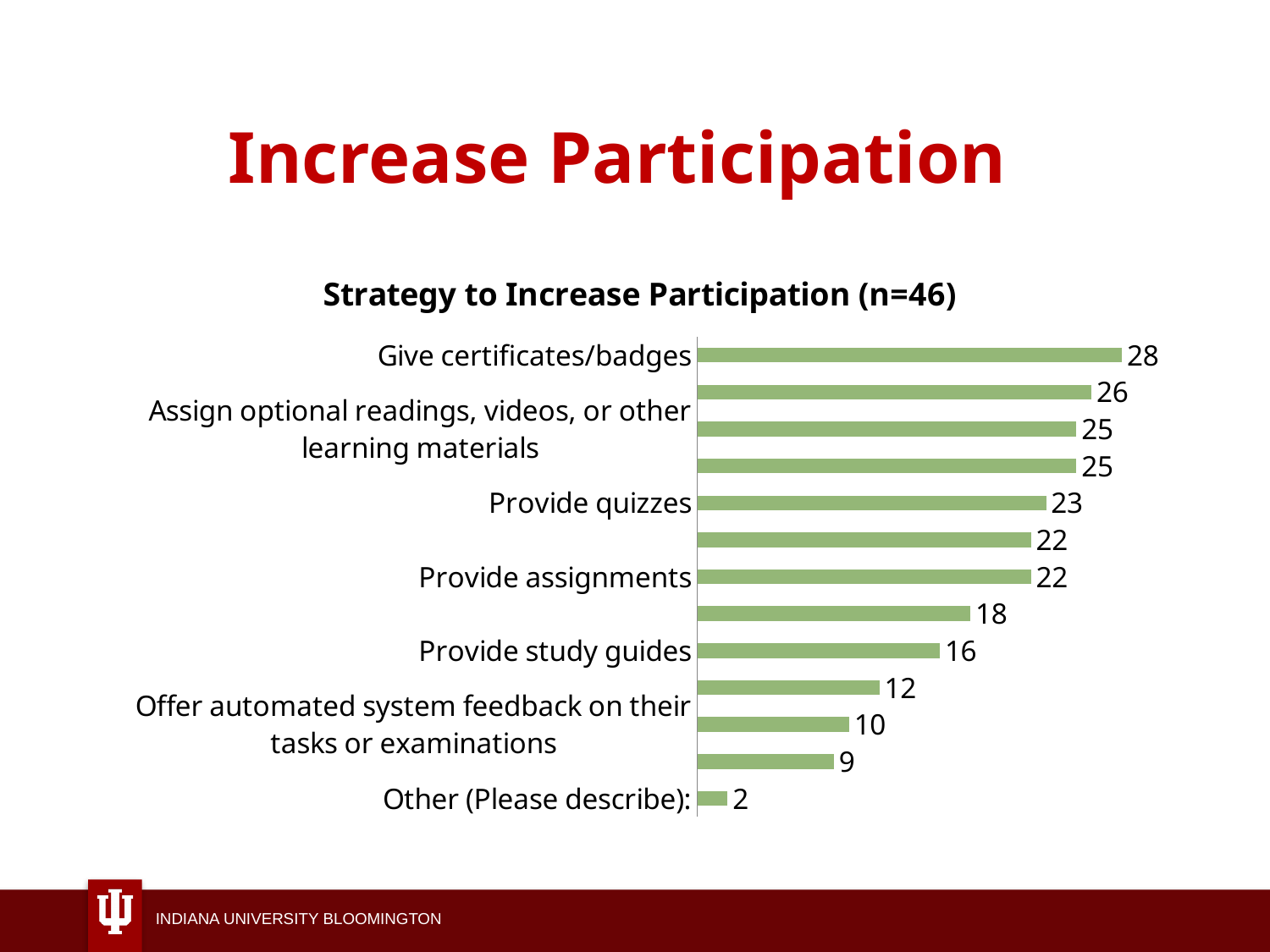
What is the value for Provide study guides? 16 Which is larger, the value for Provide assignments or the value for Provide study guides? Provide assignments What is the value for Other (Please describe):? 2 What is the value for Provide assignments? 22 What is the difference between the values for Give certificates/badges and Other (Please describe):? 26 How many bars are plotted in the chart? 13 Which strategy has the highest value? Give certificates/badges What is the difference between the values for Provide quizzes and Provide study guides? 7 What is the value for Provide quizzes? 23 What is the title of the chart? Strategy to Increase Participation (n=46) What is the value for Give certificates/badges? 28 Which category has the lowest value? Other (Please describe):